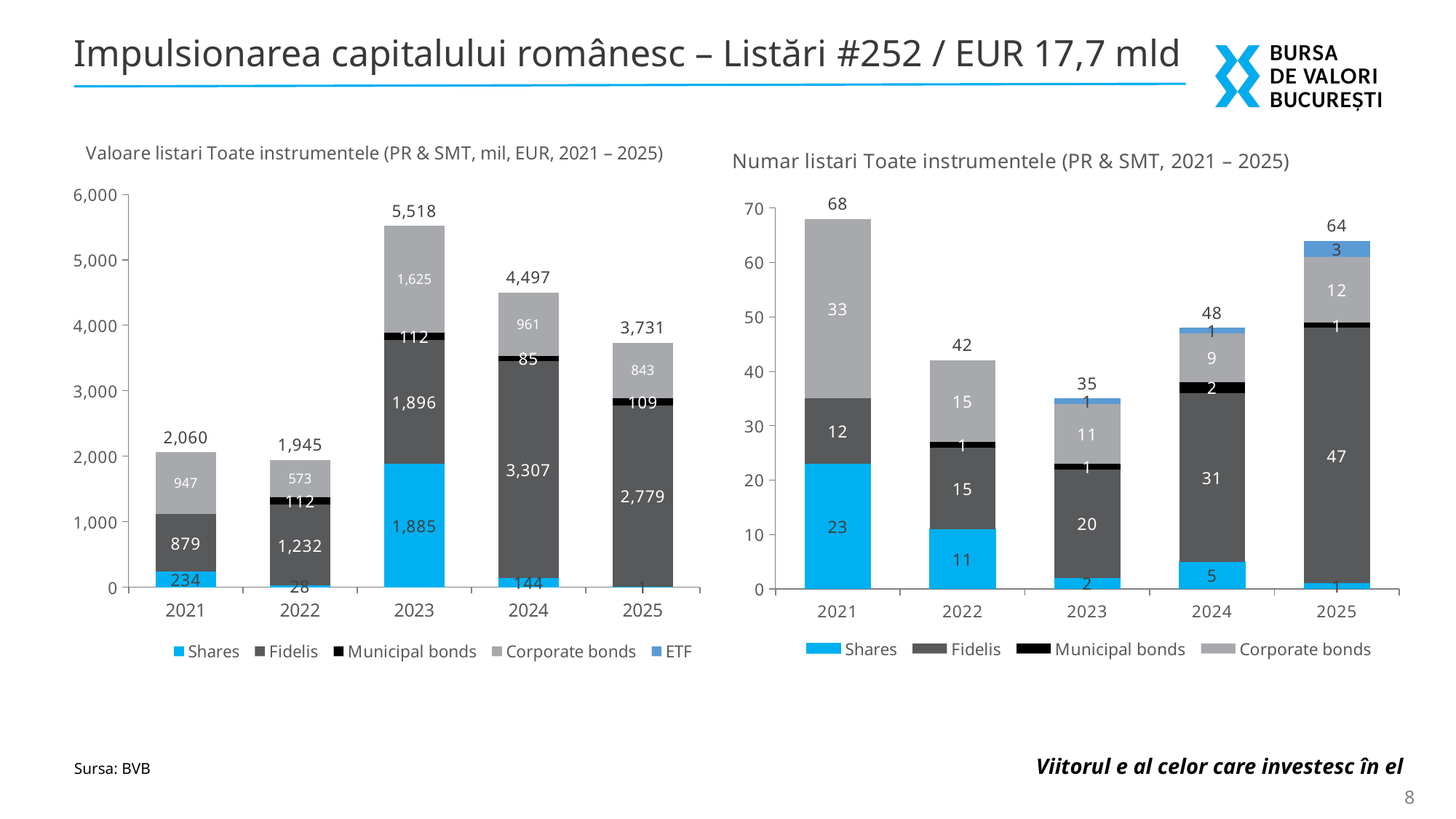
In the 'Numar listari' chart on the right, which year has the lowest total? 2023 In the 'Numar listari' chart on the right, how many years are shown on the x axis? 5 In the 'Valoare listari' chart on the left, what is the total value for 2023? 5,518 What kind of chart is the 'Numar listari' chart on the right? Stacked bar chart In the 'Valoare listari' chart on the left, what is the difference between the 2023 total and the 2024 total? 1,021 In the 'Numar listari' chart on the right, is the Shares value for 2021 larger or the Shares value for 2022? 2021 In the 'Valoare listari' chart on the left, how many series does the legend list? 5 In the 'Valoare listari' chart on the left, what is the Fidelis value for 2024? 3,307 In the 'Numar listari' chart on the right, what is the Fidelis value for 2025? 47 In the 'Numar listari' chart on the right, what is the total number of listings for 2021? 68 In the 'Valoare listari' chart on the left, which year has the highest total? 2023 In the 'Valoare listari' chart on the left, which year has the lowest total? 2022